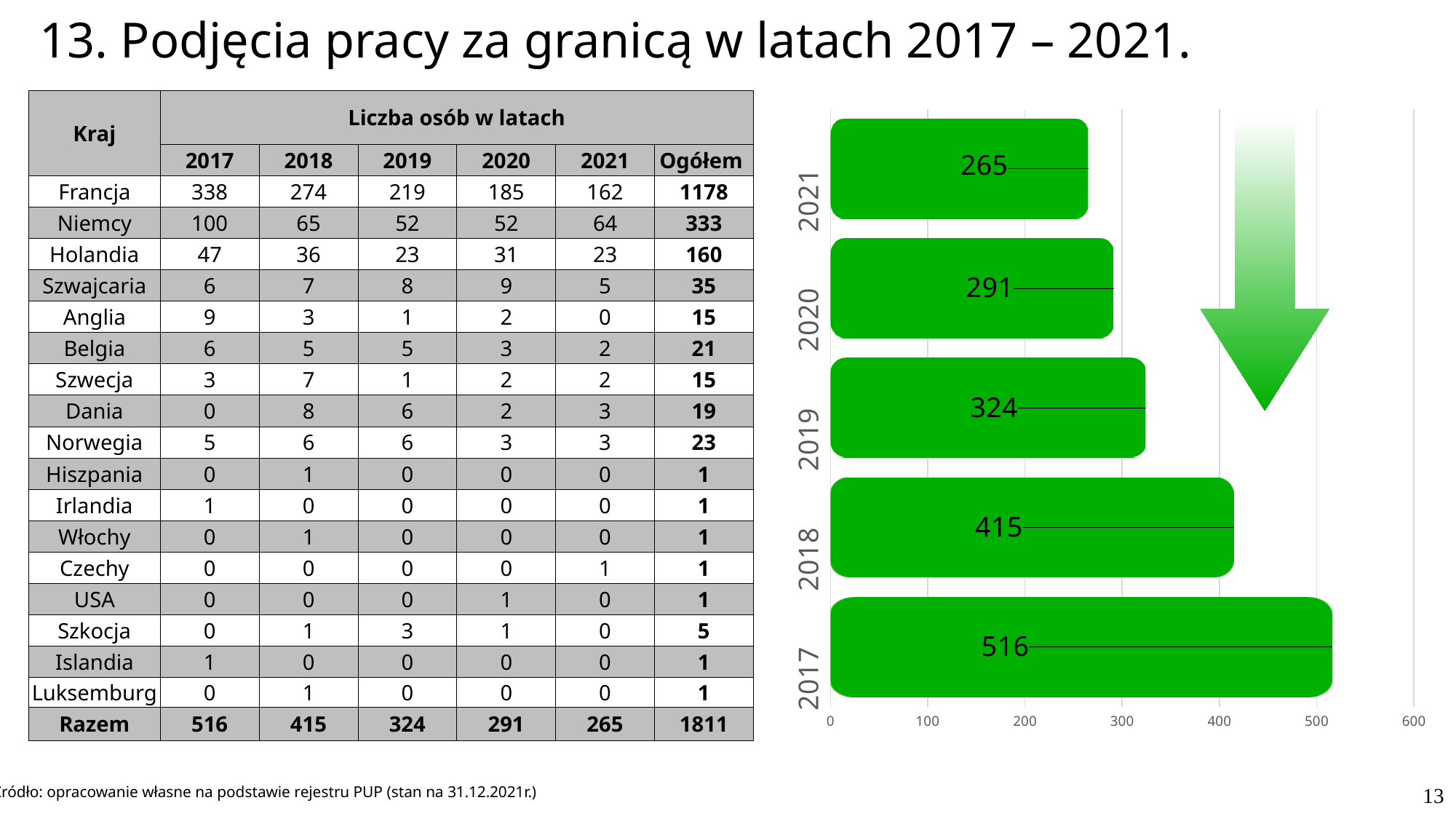
Is the value for 2018 in the bar chart greater or less than 400? greater What is the value for 2019 in the bar chart? 324 How many years are shown in the bar chart? 5 What is the value for 2021 in the bar chart? 265 Which is larger in the bar chart, the value for 2020 or the value for 2019? 2019 What is the value for 2017 in the bar chart? 516 What is the difference between the values for 2017 and 2021 in the bar chart? 251 What is the difference between the values for 2018 and 2019 in the bar chart? 91 Do the values in the bar chart rise or fall from 2017 to 2021? fall Which year has the lowest value in the bar chart? 2021 What kind of chart is shown on the slide? bar chart Which year has the highest value in the bar chart? 2017